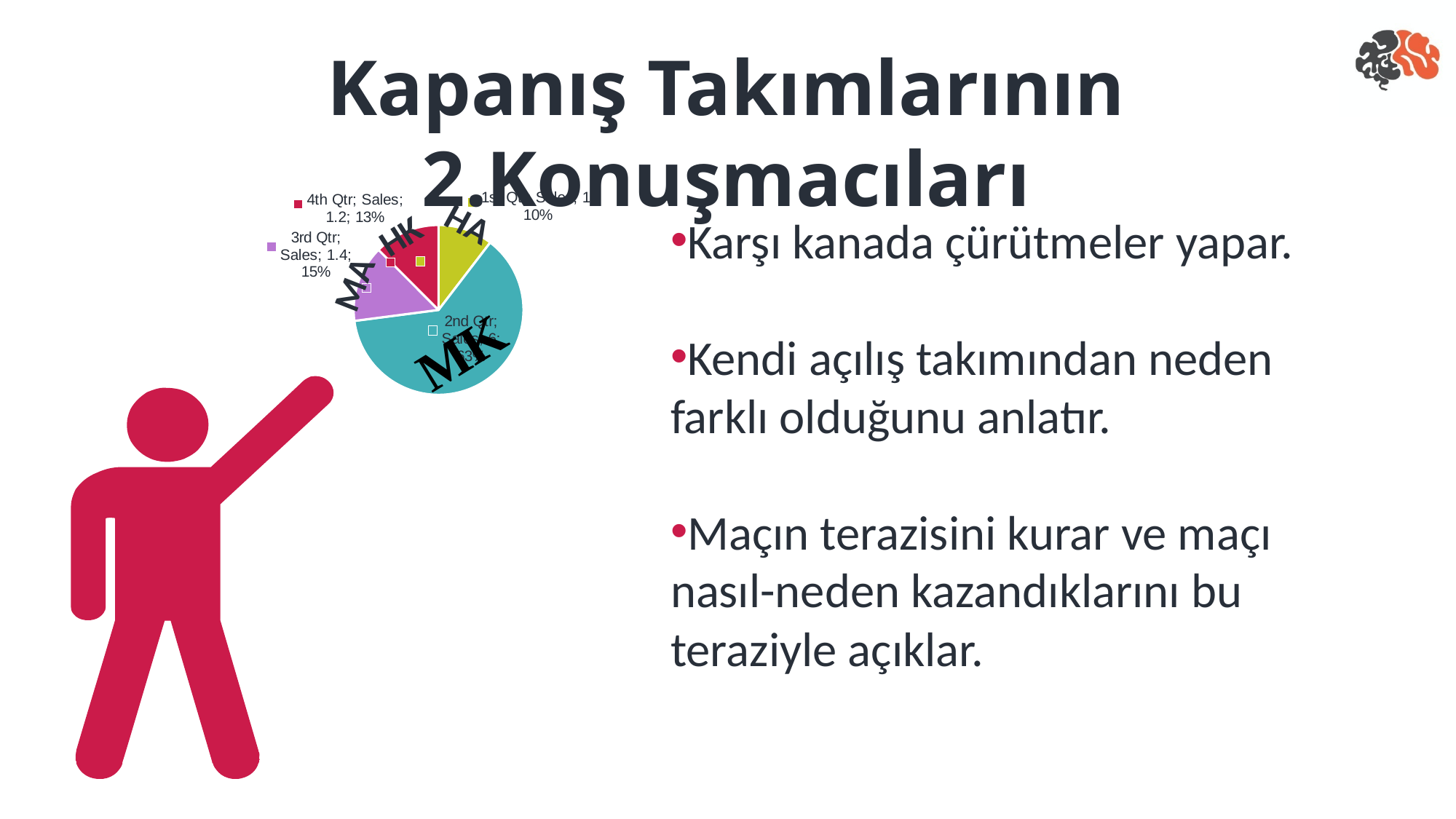
What percentage share does the 1st Qtr slice have in the pie chart? 10% Which quarter has the smallest slice in the pie chart? 1st Qtr What percentage share does the 4th Qtr slice have in the pie chart? 13% Which slice is larger in the pie chart, 3rd Qtr or 4th Qtr? 3rd Qtr How many slices does the pie chart have? 4 What percentage share does the 3rd Qtr slice have in the pie chart? 15% Which quarter has the largest slice in the pie chart? 2nd Qtr What kind of chart is shown on the slide? pie chart What is the difference between the Sales values for 3rd Qtr and 4th Qtr in the pie chart? 0.2 What is the name of the data series shown in the pie chart's labels? Sales What is the Sales value for 3rd Qtr in the pie chart? 1.4 What is the Sales value for 4th Qtr in the pie chart? 1.2